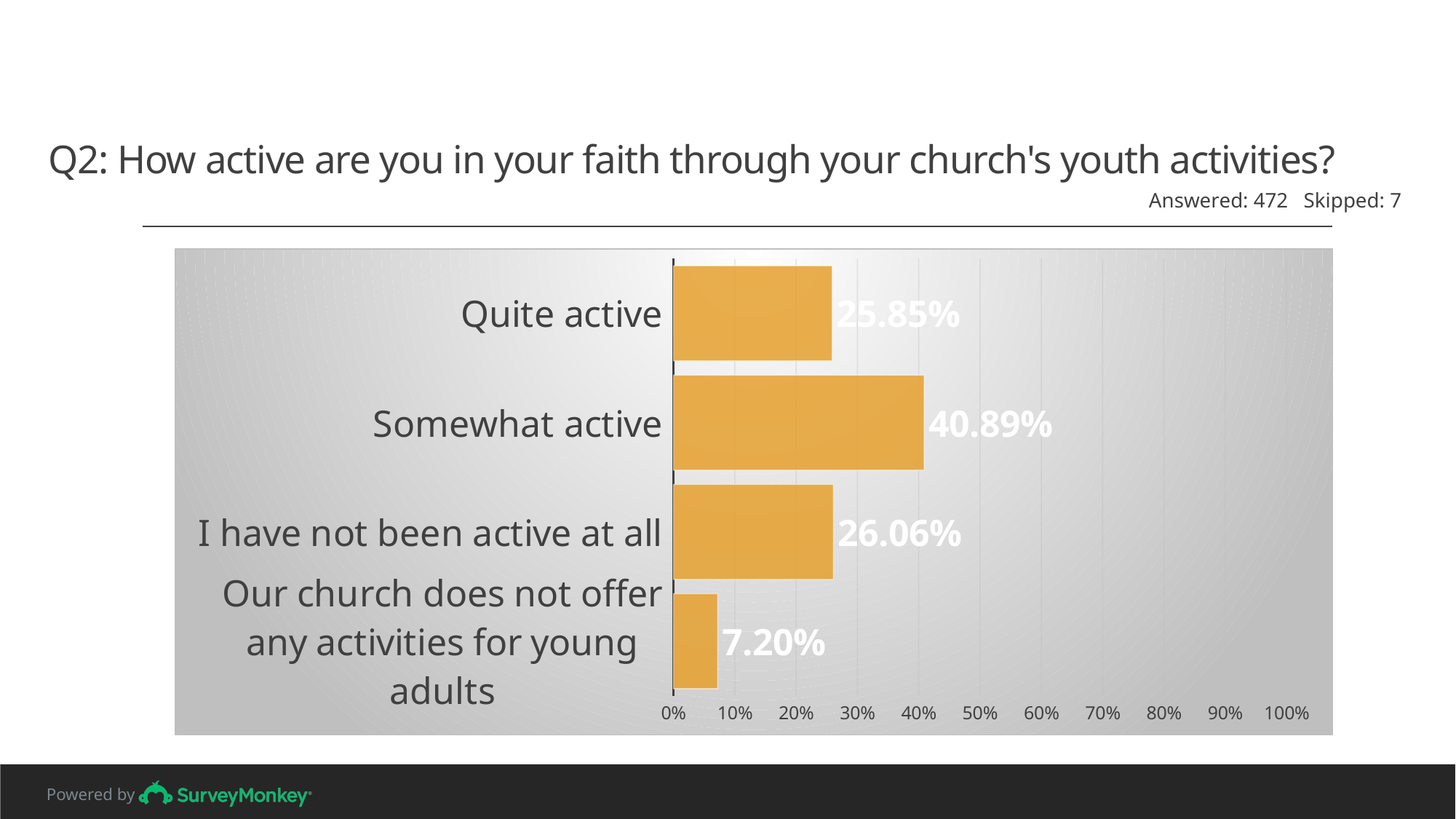
What is the difference in percentage points between "Somewhat active" and "Quite active"? 15.04 What percentage of respondents answered "Our church does not offer any activities for young adults"? 7.20% Which response option has the lowest percentage? Our church does not offer any activities for young adults Which response option has the highest percentage? Somewhat active Is the value for "Somewhat active" greater or less than 30%? greater What percentage of respondents answered "Somewhat active"? 40.89% How many response options are shown in the chart? 4 What percentage of respondents answered "Quite active"? 25.85% How many respondents answered this question? 472 What kind of chart is shown on the slide? Bar chart Which is larger: the percentage for "Somewhat active" or for "I have not been active at all"? Somewhat active What percentage of respondents answered "I have not been active at all"? 26.06%